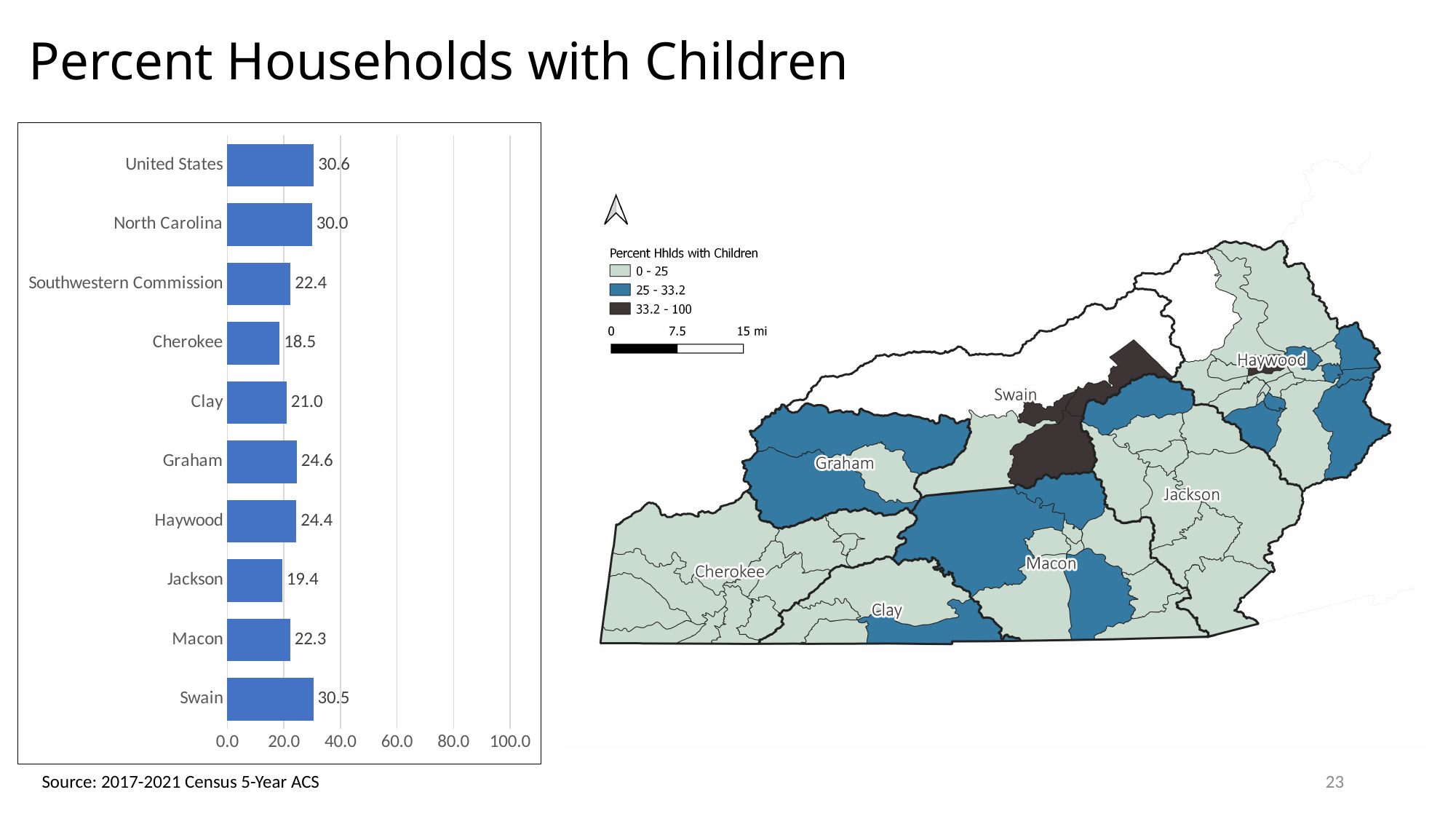
What is the difference between the values for Graham and Haywood in the bar chart? 0.2 What is the value for Cherokee in the bar chart? 18.5 Which category has the lowest value in the bar chart? Cherokee What is the title of the slide containing the bar chart? Percent Households with Children What is the value for Swain in the bar chart? 30.5 Is the value for Swain in the bar chart greater or less than 20.0? greater What kind of chart is shown on the left of the slide? Bar chart What is the value for the Southwestern Commission in the bar chart? 22.4 What is the difference between the values for North Carolina and Jackson in the bar chart? 10.6 Which has a larger value in the bar chart, Clay or Macon? Macon How many categories are shown in the bar chart? 10 Which category has the highest value in the bar chart? United States